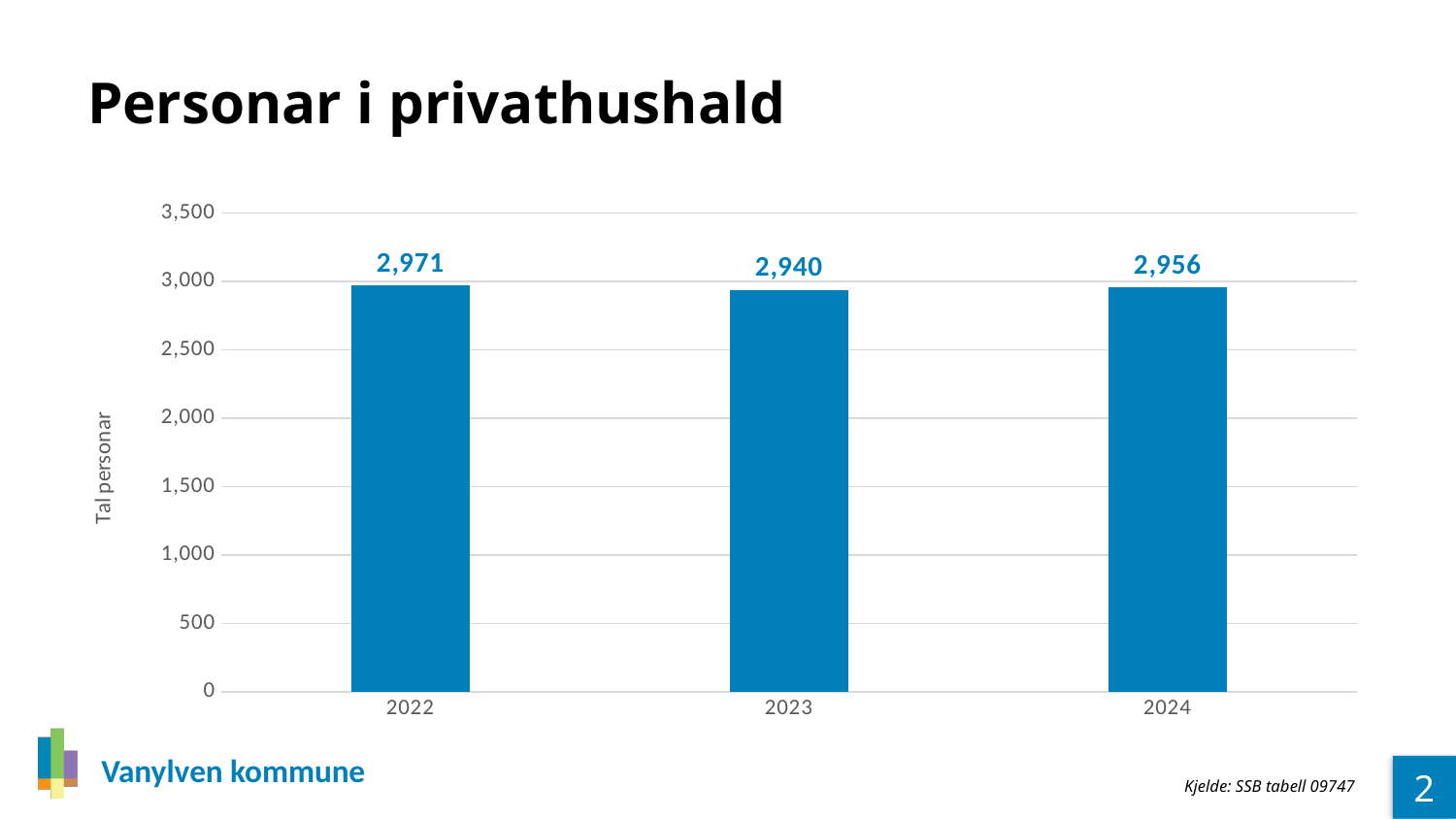
What is the value for 2023? 2,940 What kind of chart is shown on the slide? bar chart Which year has the highest value? 2022 What is the value for 2024? 2,956 What is the difference between the values for 2024 and 2023? 16 Is the value for 2023 greater or less than 3,000? less What is the title of the chart? Personar i privathushald What is the difference between the values for 2022 and 2023? 31 What is the value for 2022? 2,971 How many years are shown on the x axis? 3 Which is larger, the value for 2022 or the value for 2024? 2022 Which year has the lowest value? 2023